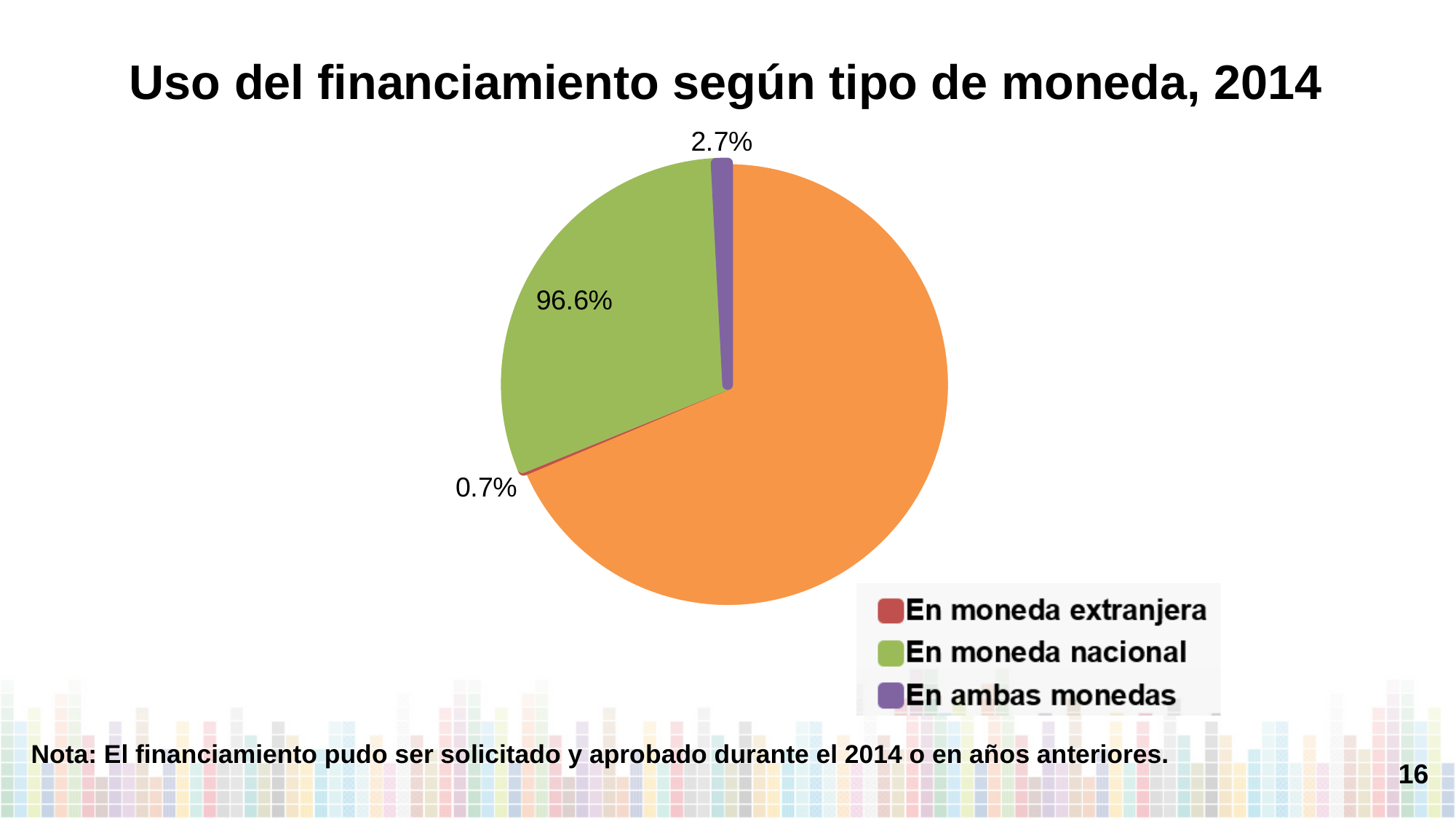
What percentage is shown for 'En ambas monedas'? 2.7% What colour represents 'En ambas monedas' in the legend? Purple What is the difference in percentage points between 'En moneda nacional' and 'En ambas monedas'? 93.9 Which is larger, the percentage for 'En ambas monedas' or for 'En moneda extranjera'? En ambas monedas What is the title of the chart? Uso del financiamiento según tipo de moneda, 2014 Which legend category has the lowest percentage label? En moneda extranjera What is the difference in percentage points between 'En ambas monedas' and 'En moneda extranjera'? 2.0 What kind of chart is shown on the slide? Pie chart What percentage is shown for 'En moneda extranjera'? 0.7% How many categories does the legend list? 3 Which legend category has the highest percentage label? En moneda nacional What percentage is shown for 'En moneda nacional'? 96.6%